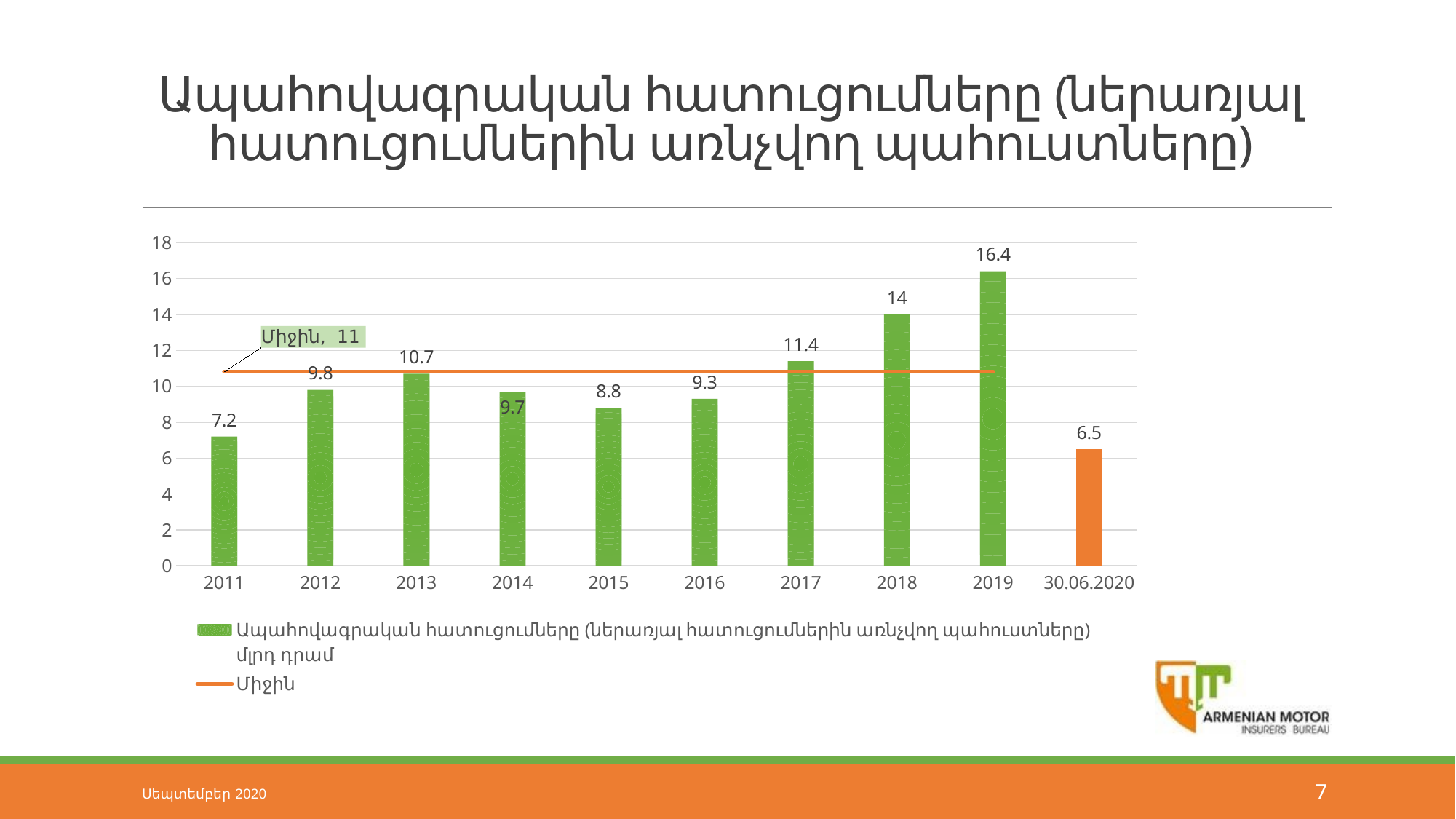
What is the value for 2019? 16.4 Which year has the highest value? 2019 How many categories are shown on the x axis? 10 What is the value for 2017? 11.4 What is the value of the average (Միջին) line shown on the chart? 11 How many series does the legend list? 2 Which is larger, the value for 2013 or the value for 2014? 2013 What is the difference between the values for 2019 and 2018? 2.4 What is the value for 30.06.2020? 6.5 What is the value for 2011? 7.2 Which category has the lowest value? 30.06.2020 What kind of chart is this? combination bar and line chart